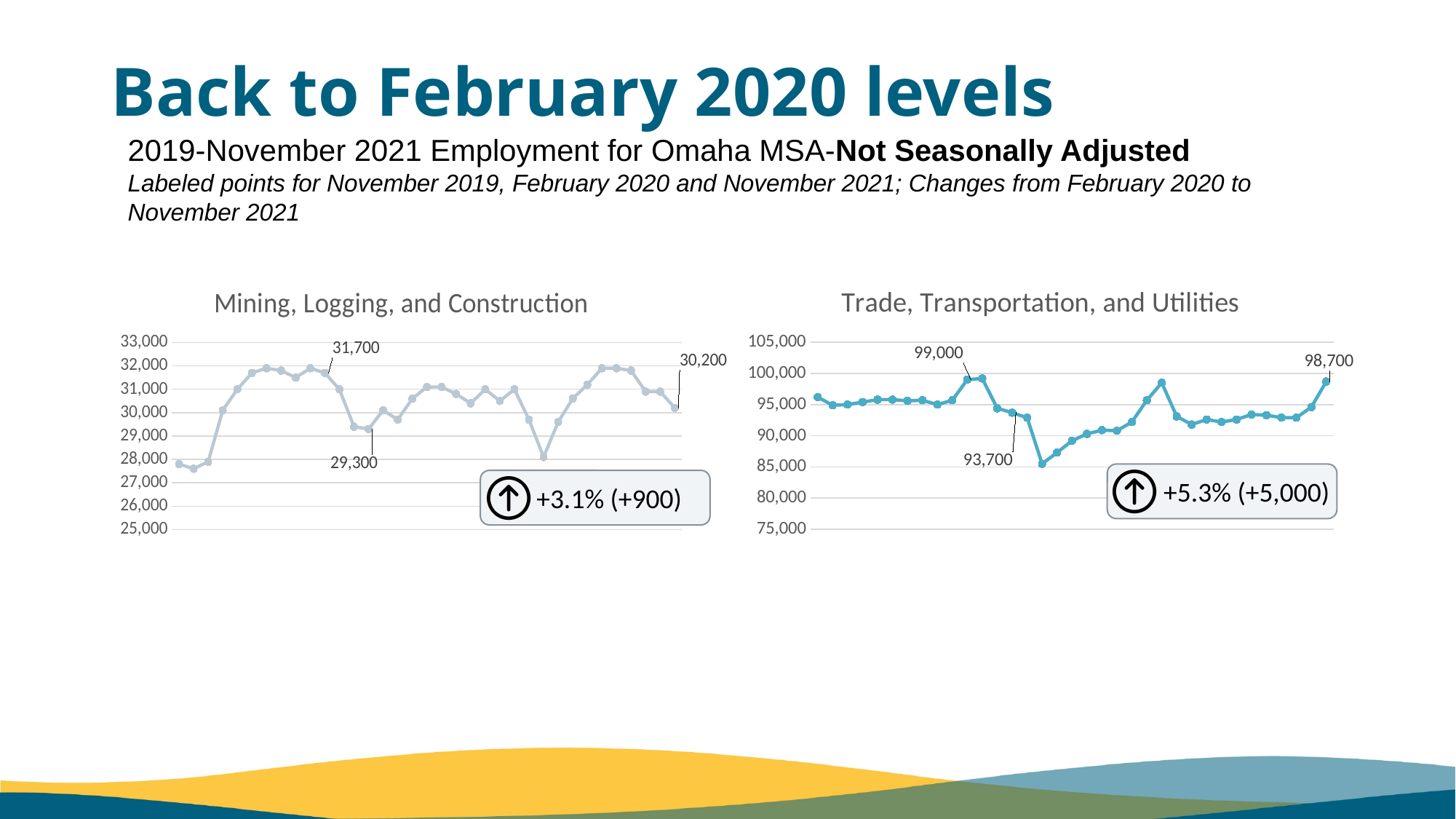
In the Mining, Logging, and Construction chart, what is the labeled value for November 2021? 30,200 In the Trade, Transportation, and Utilities chart, what is the labeled value for November 2019? 99,000 What percentage change from February 2020 to November 2021 is shown in the callout on the Trade, Transportation, and Utilities chart? +5.3% (+5,000) What kind of chart is the Trade, Transportation, and Utilities chart? line chart In the Trade, Transportation, and Utilities chart, what is the difference between the November 2019 value and the November 2021 value? 300 In the Mining, Logging, and Construction chart, what is the labeled value for November 2019? 31,700 In the Trade, Transportation, and Utilities chart, what is the labeled value for November 2021? 98,700 In the Mining, Logging, and Construction chart, what is the labeled value for February 2020? 29,300 In the Trade, Transportation, and Utilities chart, is the lowest point on the line greater or less than 90,000? less In the Mining, Logging, and Construction chart, which labeled value is larger: November 2019 or November 2021? November 2019 In the Trade, Transportation, and Utilities chart, what is the labeled value for February 2020? 93,700 In the Mining, Logging, and Construction chart, what is the difference between the November 2021 value and the February 2020 value? 900